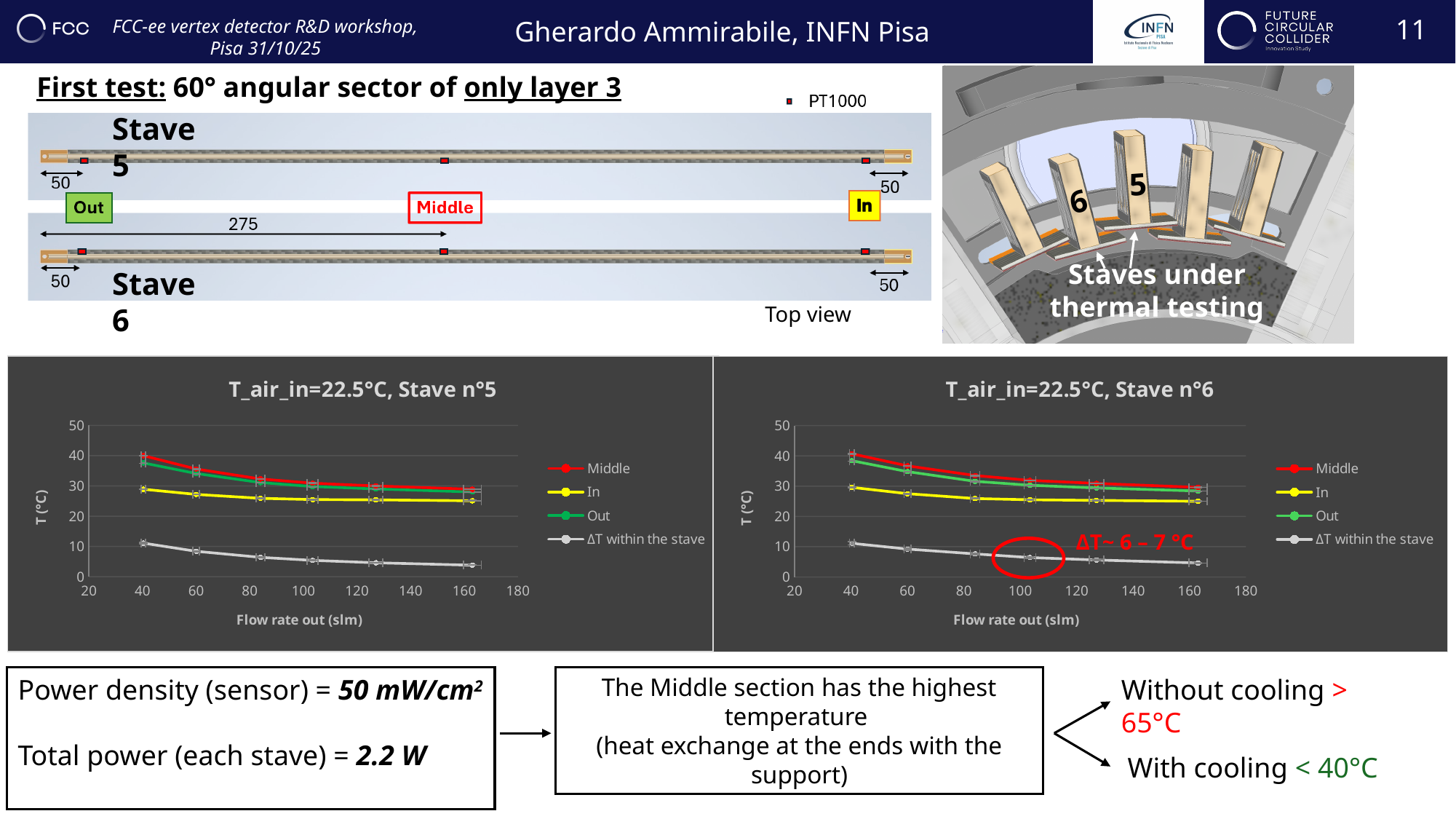
What kind of chart is the 'T_air_in=22.5°C, Stave n°5' chart? line chart In the 'T_air_in=22.5°C, Stave n°6' chart, which series has the lowest values across the whole flow rate range? ΔT within the stave In the 'T_air_in=22.5°C, Stave n°5' chart, which series is higher at a flow rate of 40 slm, Middle or In? Middle In the 'T_air_in=22.5°C, Stave n°6' chart, is the Out temperature at a flow rate of 40 slm greater or less than 30? greater In the 'T_air_in=22.5°C, Stave n°6' chart, which colour is used for the Middle series? red How many series does the legend of the 'T_air_in=22.5°C, Stave n°6' chart list? 4 In the 'T_air_in=22.5°C, Stave n°5' chart, is the Middle temperature at a flow rate of 40 slm greater or less than 30? greater In the 'T_air_in=22.5°C, Stave n°6' chart, does the 'ΔT within the stave' series rise or fall as the flow rate out increases? fall In the 'T_air_in=22.5°C, Stave n°6' chart, is the In temperature at a flow rate of about 160 slm greater or less than 30? less What is the x-axis label of the 'T_air_in=22.5°C, Stave n°5' chart? Flow rate out (slm) In the 'T_air_in=22.5°C, Stave n°5' chart, does the Middle temperature rise or fall as the flow rate out increases? fall